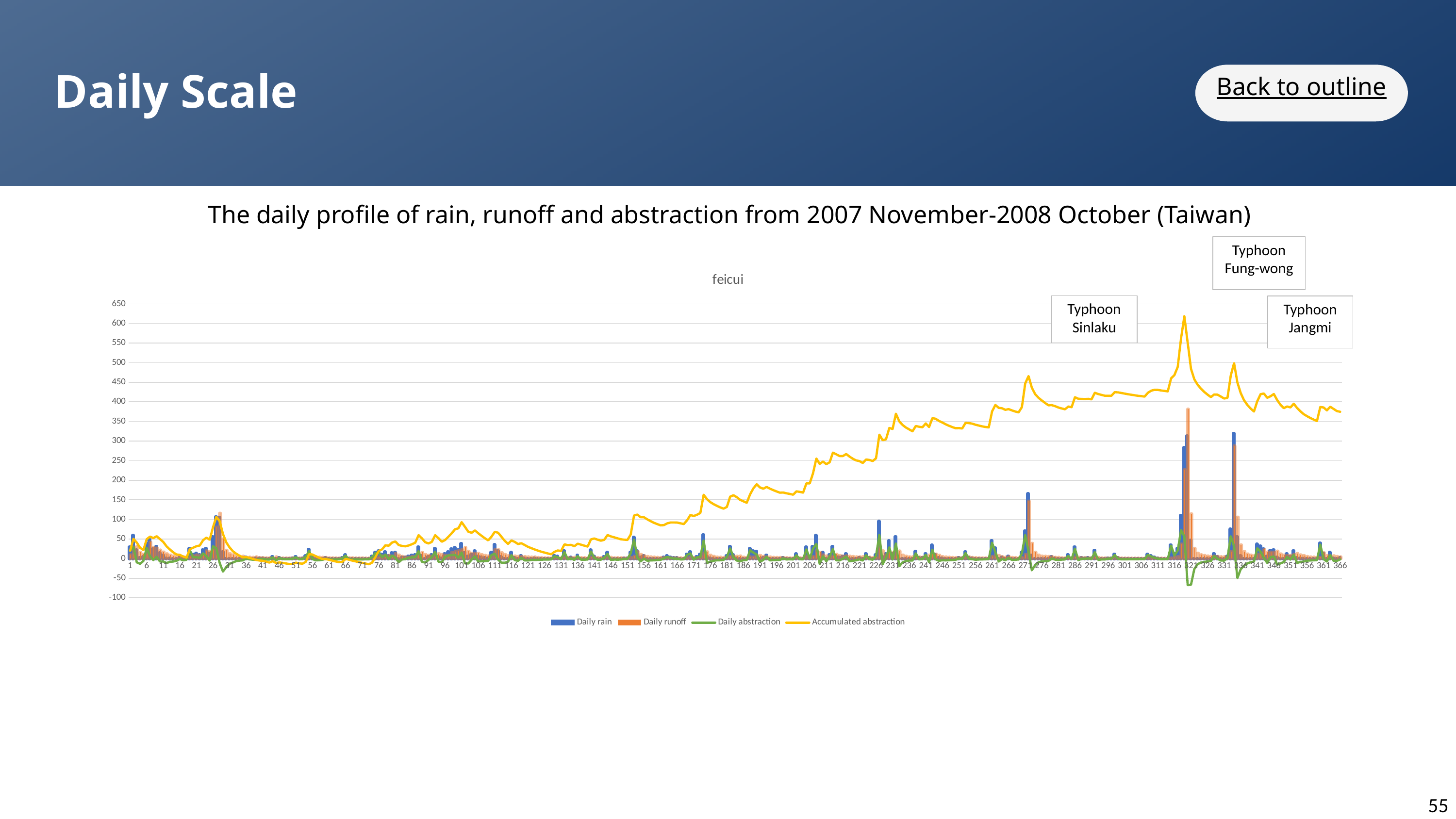
Which series is drawn as a yellow line? Accumulated abstraction Which series reaches the highest value on the chart? Accumulated abstraction Is the peak value of Accumulated abstraction greater or less than 550? greater Is the lowest value of Daily abstraction greater or less than 0? less Is the highest Daily rain bar greater or less than 250? greater What is the highest value shown on the y axis? 650 How many series does the legend list? 4 Does the Accumulated abstraction line generally rise or fall from day 1 to day 366? Rise What is the title shown directly above the plot area? feicui What is the last label on the x axis? 366 What kind of chart is this? Combination chart of bars and lines